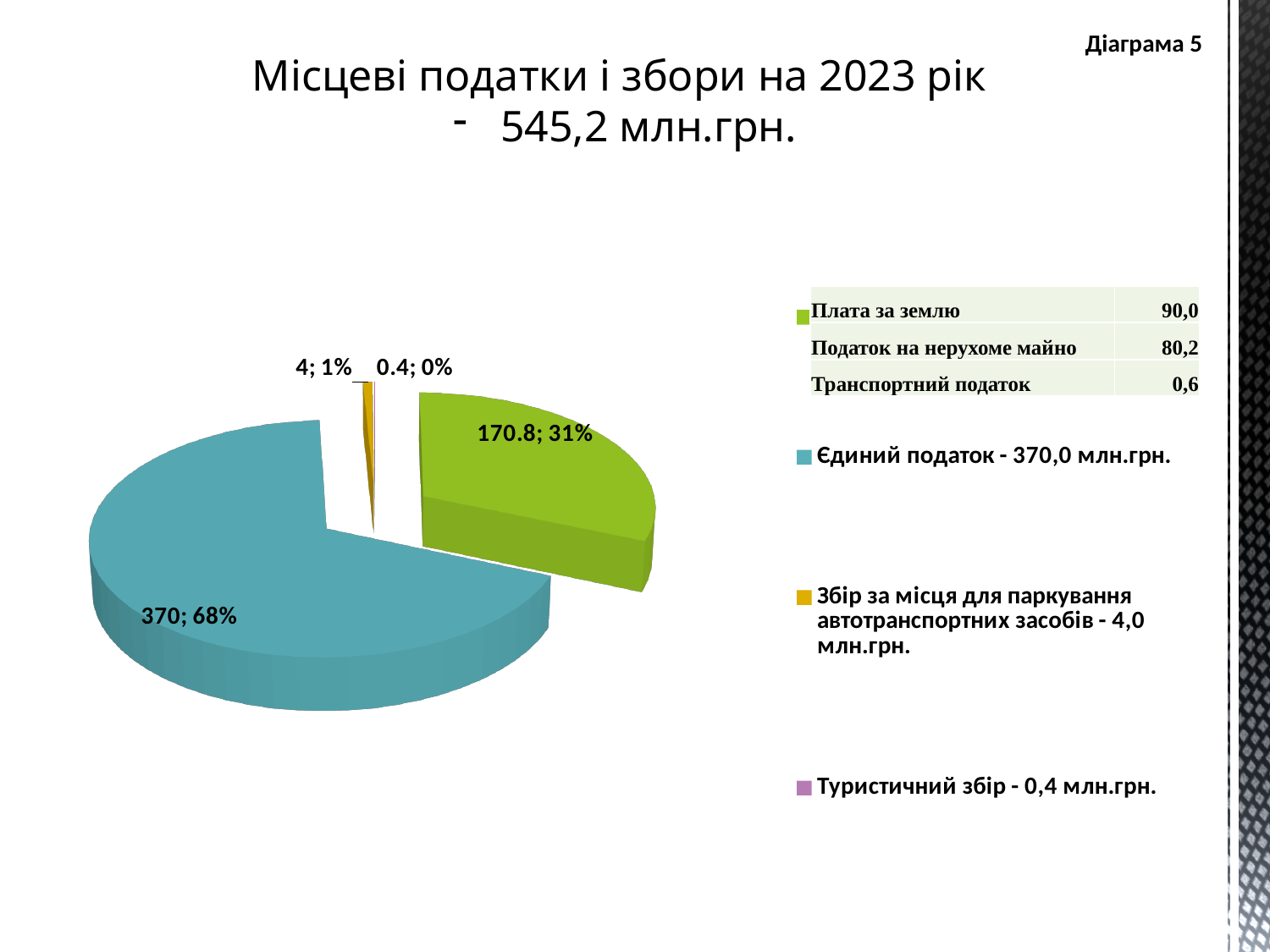
What value is labelled on the green slice of the pie? 170.8 What percentage share does the green slice (Плата за землю, Податок на нерухоме майно, Транспортний податок) have? 31% Which slice of the pie is the largest? Єдиний податок What percentage share is shown for the Туристичний збір slice? 0% What is the difference between the Єдиний податок value (370) and the green slice value (170.8)? 199.2 What kind of chart is shown on the slide? pie chart What value is labelled on the slice for Збір за місця для паркування автотранспортних засобів? 4 What percentage share does the Єдиний податок slice have? 68% What is the value shown for the Єдиний податок slice? 370 How many slices does the pie chart have? 4 Which slice of the pie is the smallest? Туристичний збір What total amount of local taxes and fees for 2023 is stated in the slide title? 545,2 млн.грн.